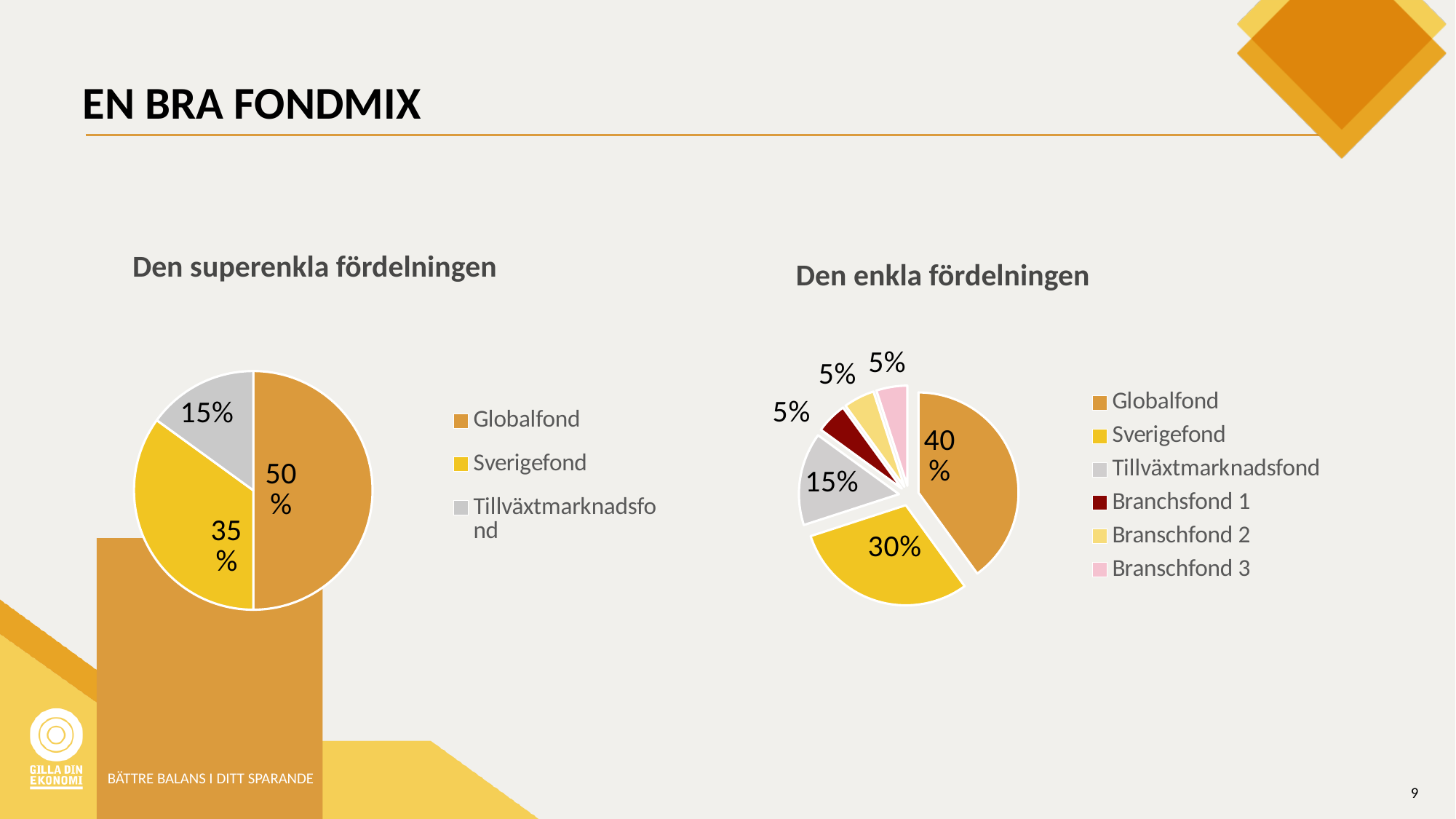
What kind of chart is 'Den enkla fördelningen'? Pie chart In the 'Den superenkla fördelningen' chart, what share does Sverigefond have? 35% In the 'Den superenkla fördelningen' chart, how many slices does the pie have? 3 In the 'Den superenkla fördelningen' chart, what is the difference between the Globalfond and Sverigefond shares? 15% In the 'Den enkla fördelningen' chart, what share does Tillväxtmarknadsfond have? 15% In the 'Den superenkla fördelningen' chart, which category has the smallest share? Tillväxtmarknadsfond In the 'Den enkla fördelningen' chart, which category has the largest share? Globalfond In the 'Den enkla fördelningen' chart, what colour is the Branchsfond 1 slice? Dark red In the 'Den enkla fördelningen' chart, which is larger: Sverigefond or Tillväxtmarknadsfond? Sverigefond In the 'Den enkla fördelningen' chart, what share does Globalfond have? 40% In the 'Den enkla fördelningen' chart, how many categories does the legend list? 6 In the 'Den superenkla fördelningen' chart, what share does Globalfond have? 50%